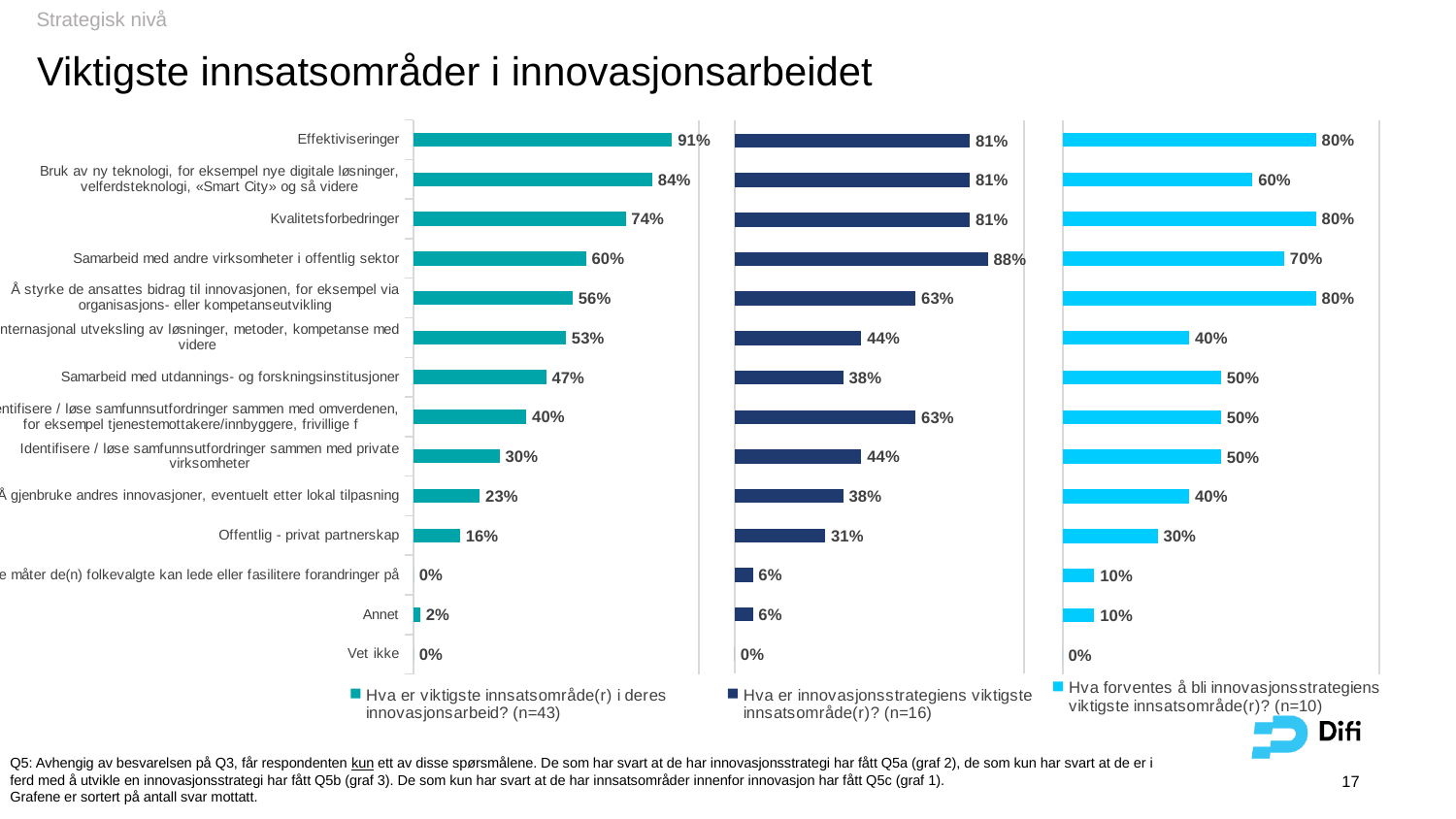
In the middle chart (n=16), which category has the highest value? Samarbeid med andre virksomheter i offentlig sektor In the left chart (n=43), what is the value for Effektiviseringer? 91% In the middle chart (n=16), what is the value for Offentlig - privat partnerskap? 31% What kind of chart is used on this slide? Bar chart In the left chart (n=43), what is the difference between Effektiviseringer and Kvalitetsforbedringer? 17 percentage points In the middle chart (n=16), what is the difference between Effektiviseringer and Samarbeid med utdannings- og forskningsinstitusjoner? 43 percentage points In the left chart (n=43), which is larger: Samarbeid med andre virksomheter i offentlig sektor or Samarbeid med utdannings- og forskningsinstitusjoner? Samarbeid med andre virksomheter i offentlig sektor How many categories are listed in each chart on the slide? 14 In the left chart (n=43), what is the value for Annet? 2% What is the legend entry for the middle chart? Hva er innovasjonsstrategiens viktigste innsatsområde(r)? (n=16) In the right chart (n=10), what is the value for Kvalitetsforbedringer? 80% In the right chart (n=10), what is the value for Offentlig - privat partnerskap? 30%